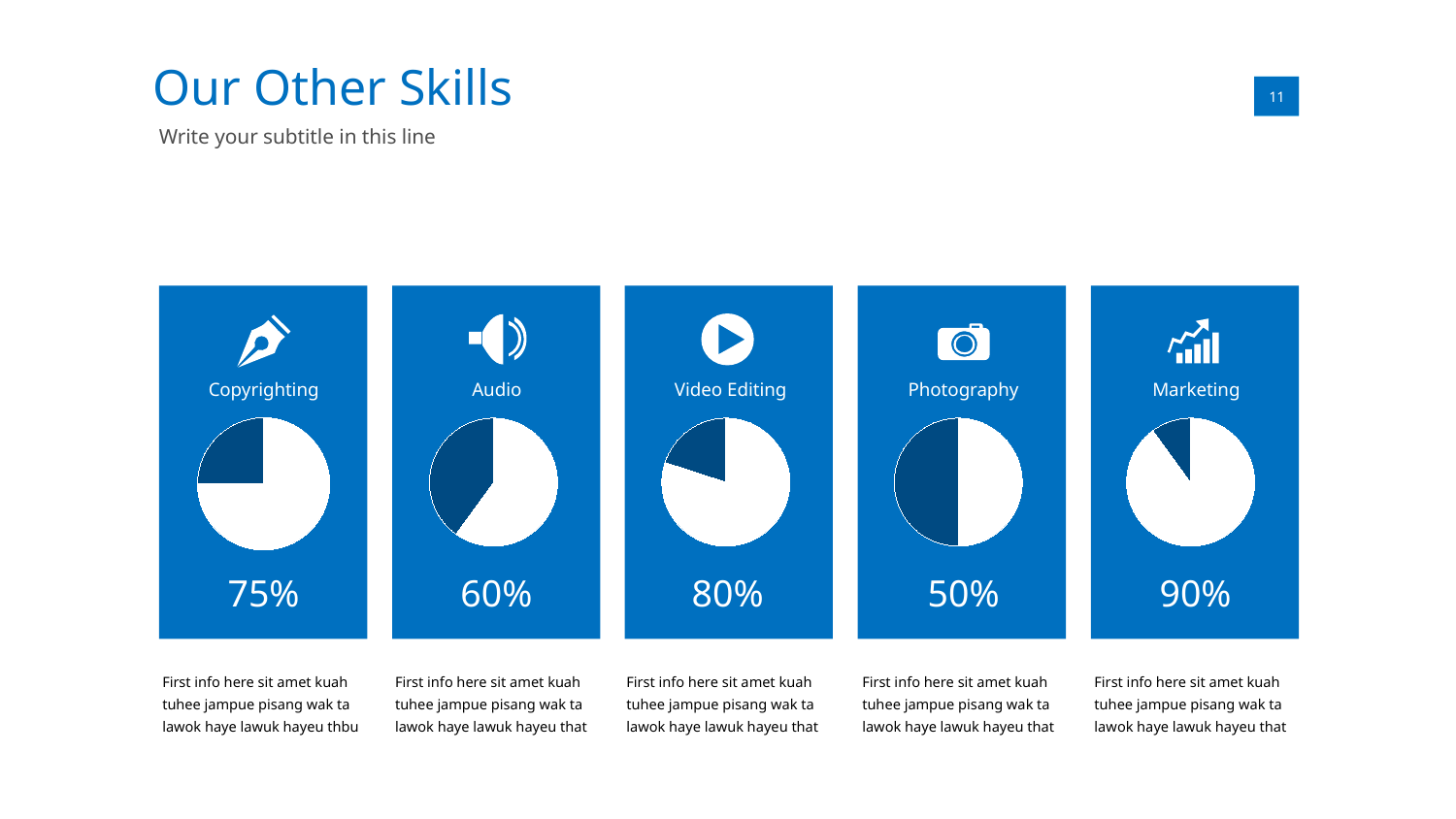
What is the difference between the Marketing percentage and the Audio percentage? 30% Which skill has the highest percentage on the slide? Marketing What kind of chart is used for each skill on the slide? Pie chart What percentage is shown for the Copyrighting chart? 75% What percentage is shown for the Photography chart? 50% What is the title of the slide? Our Other Skills How many skill charts are shown on the slide? 5 What percentage is shown for the Marketing chart? 90% Which skill has the lowest percentage on the slide? Photography What percentage is shown for the Audio chart? 60% Which is larger, the Copyrighting percentage or the Video Editing percentage? Video Editing What percentage is shown for the Video Editing chart? 80%